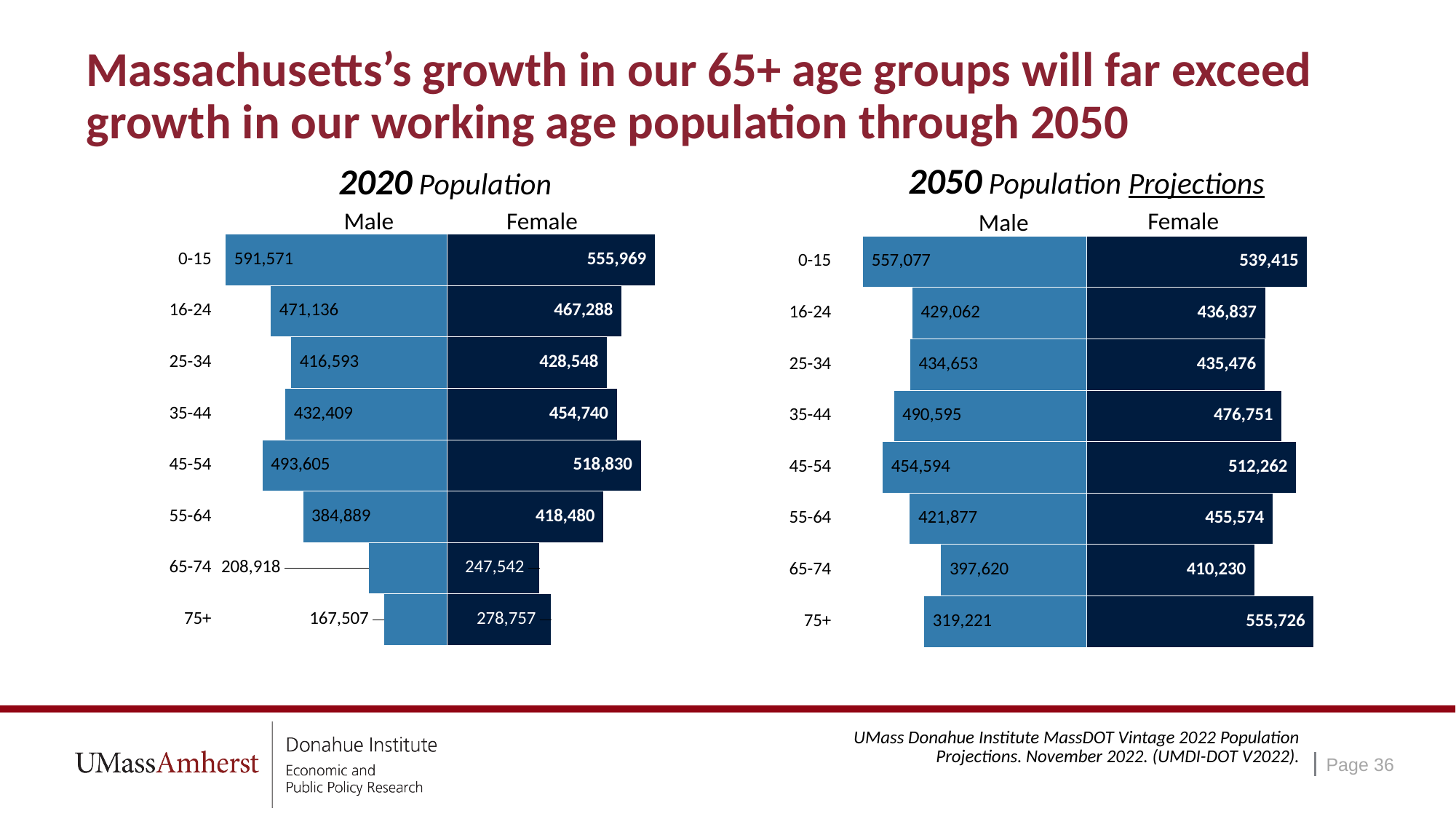
In the 2020 Population chart, what is the difference between the male and female populations for the 0-15 age group? 35,602 How many age groups are shown in the 2050 Population Projections chart? 8 In the 2020 Population chart, which age group has the lowest male population? 75+ In the 2050 Population Projections chart, what is the female population for the 75+ age group? 555,726 In the 2020 Population chart, which is larger for the 55-64 age group, the male or the female population? Female In the 2020 Population chart, what is the male population for the 0-15 age group? 591,571 What type of chart is the 2020 Population chart? Bar chart In the 2050 Population Projections chart, which age group has the highest female population? 75+ In the 2050 Population Projections chart, what is the male population for the 65-74 age group? 397,620 In the 2050 Population Projections chart, what is the difference between the female and male populations for the 75+ age group? 236,505 In the 2020 Population chart, what is the female population for the 45-54 age group? 518,830 How many series does the 2020 Population chart show? 2